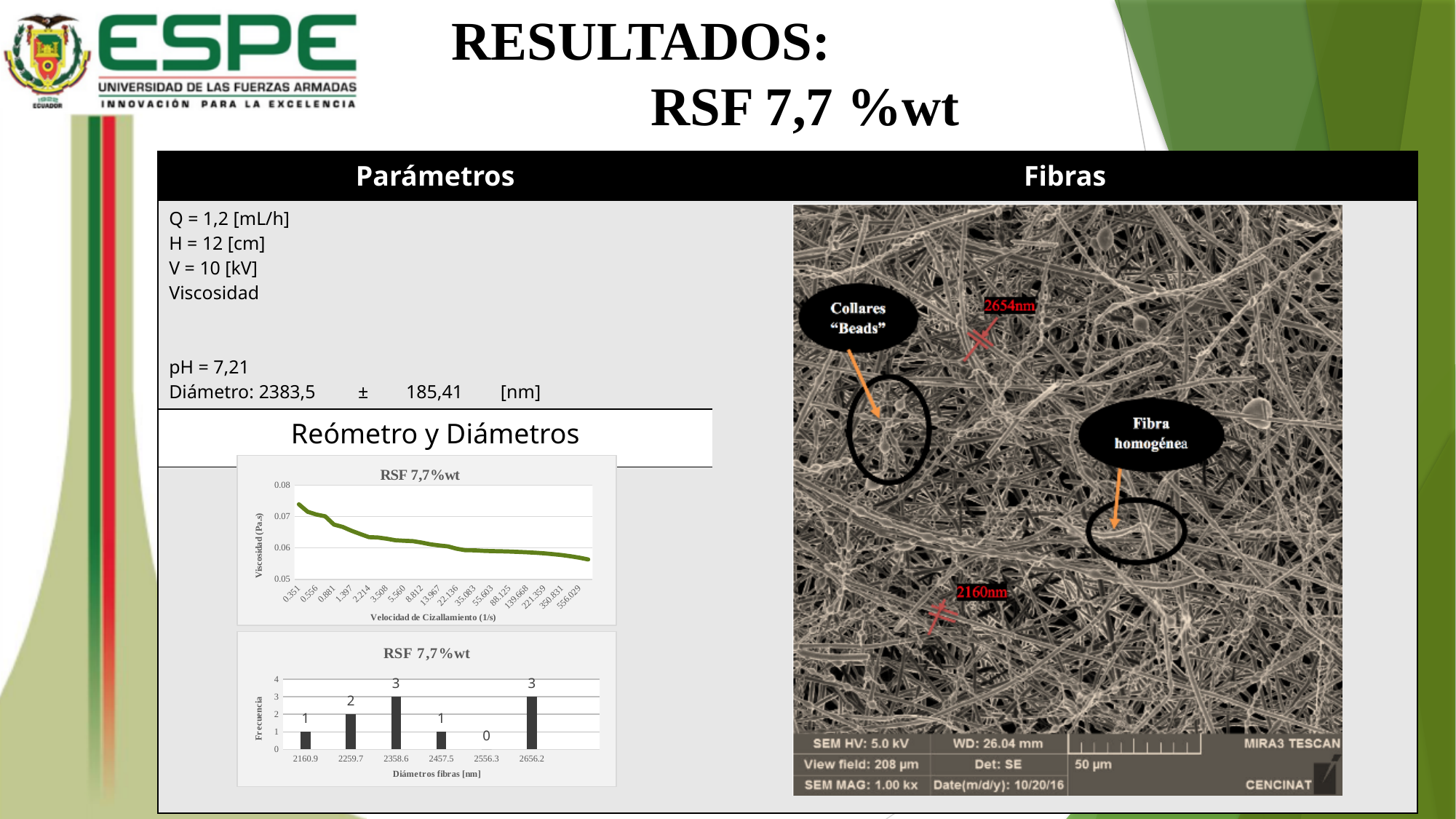
What type of chart is the upper chart titled 'RSF 7,7 %wt' (Viscosidad vs Velocidad de Cizallamiento)? line chart In the lower bar chart, how many diameter categories are shown on the x axis? 6 In the upper line chart, what is the label of the y axis? Viscosidad (Pa.s) In the upper line chart, is the viscosity at a shear rate of 0.351 greater or less than 0.07? greater In the upper line chart, does the viscosity rise or fall as the shear rate increases along the x axis? fall In the lower bar chart, what is the frequency for the diameter 2358.6? 3 In the lower bar chart, what is the frequency for the diameter 2259.7? 2 In the lower bar chart, what is the frequency for the diameter 2556.3? 0 In the lower bar chart, what is the difference between the frequency for 2656.2 and the frequency for 2457.5? 2 What type of chart is the lower chart titled 'RSF 7,7 %wt' (Frecuencia vs Diámetros fibras)? bar chart In the lower bar chart, which has a higher frequency: 2259.7 or 2160.9? 2259.7 In the lower bar chart, which diameter category has the lowest frequency? 2556.3